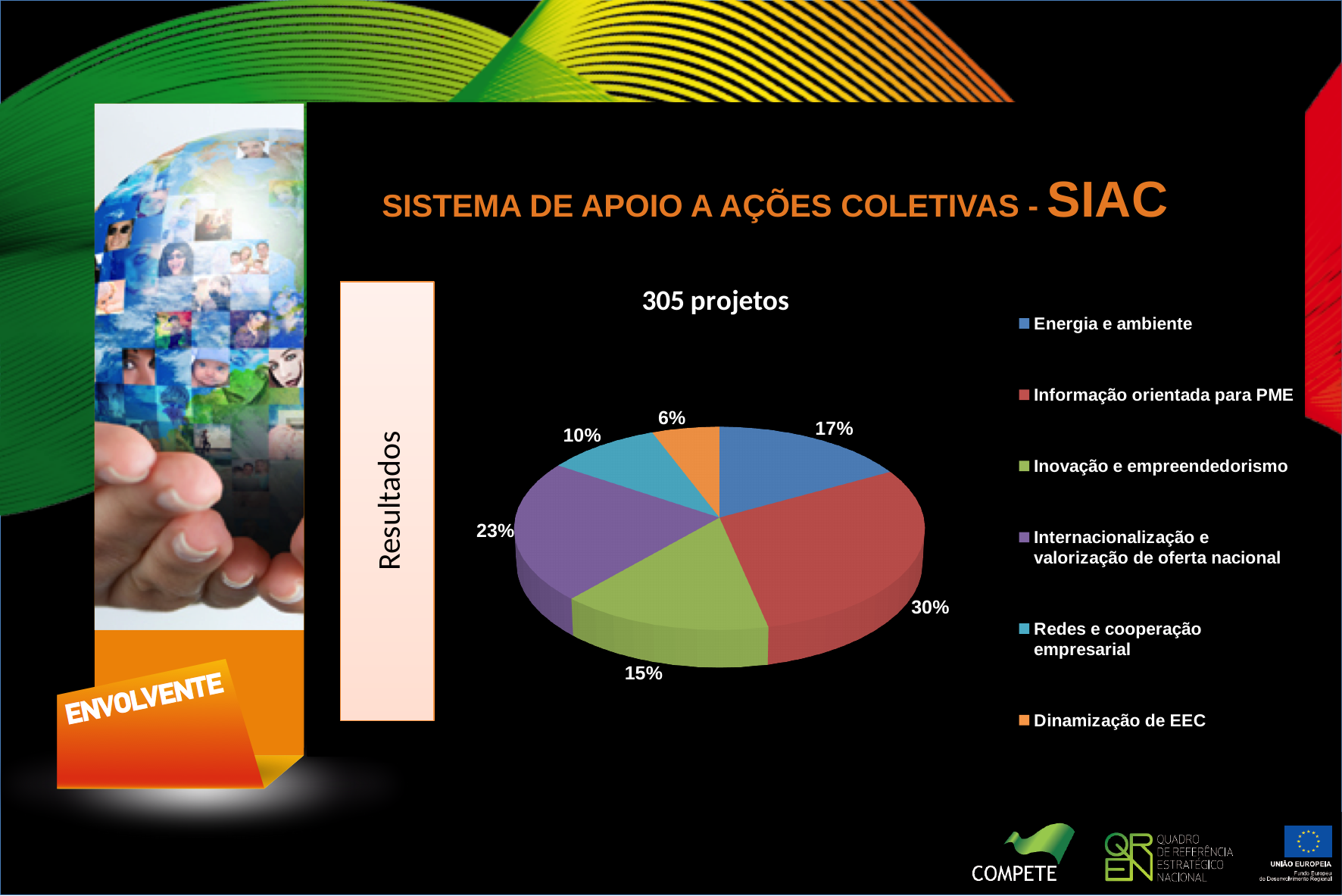
Which is larger: the share for Redes e cooperação empresarial or the share for Inovação e empreendedorismo? Inovação e empreendedorismo What kind of chart is shown on the slide? Pie chart What share of the pie does Internacionalização e valorização de oferta nacional have? 23% Which category has the largest share of the pie? Informação orientada para PME What share of the pie does Dinamização de EEC have? 6% How many slices does the pie chart have? 6 Which category has the smallest share of the pie? Dinamização de EEC What is the difference in percentage points between Informação orientada para PME and Inovação e empreendedorismo? 15 What share of the pie does Energia e ambiente have? 17% What is the title of the pie chart? 305 projetos Which colour represents Internacionalização e valorização de oferta nacional in the legend? Purple